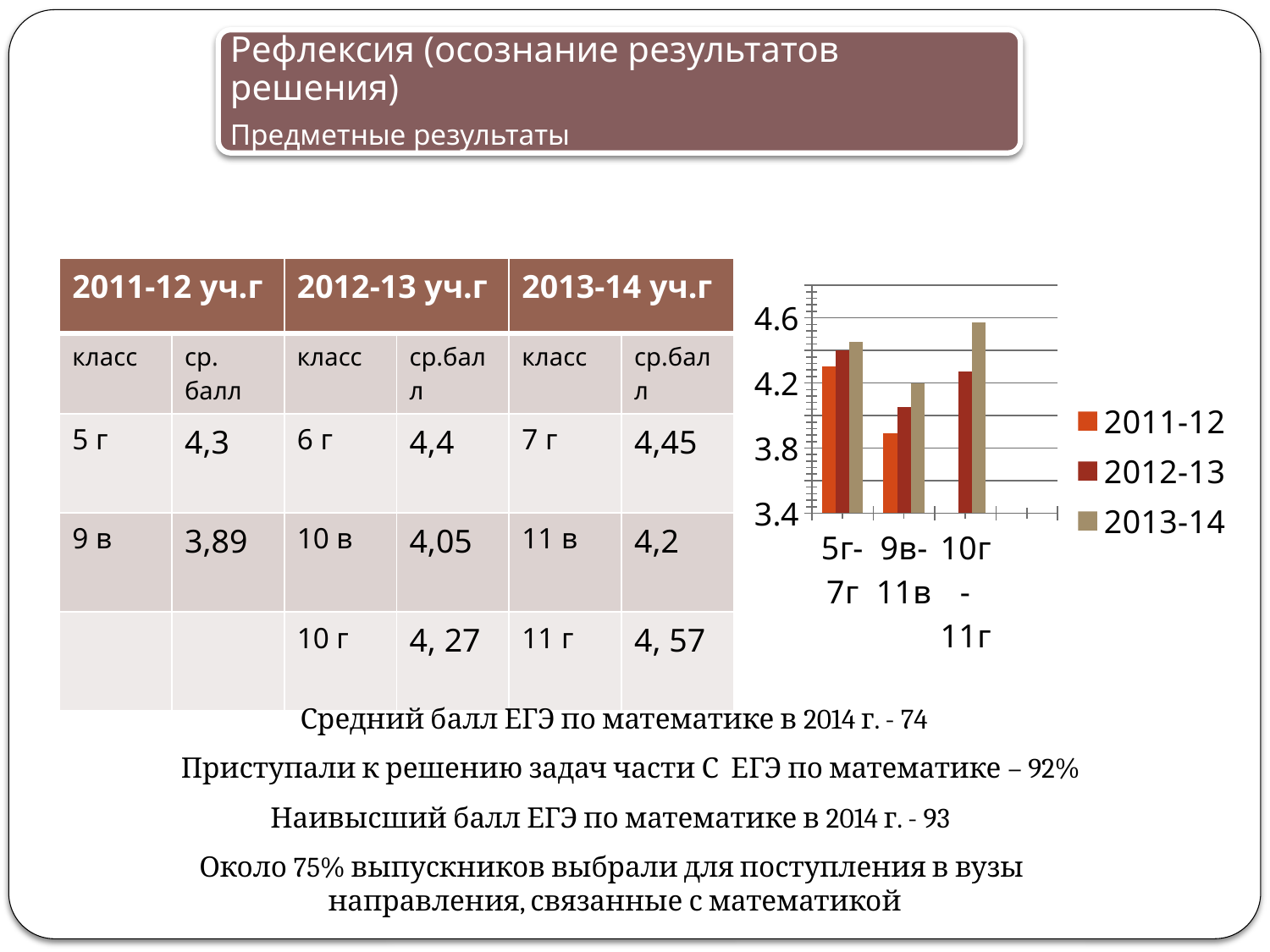
Within the 9в-11в category, do the values rise or fall from 2011-12 to 2013-14? rise Which category in the chart has no bar for the 2011-12 series? 10г-11г How many series does the chart legend list? 3 Is the 2012-13 value for 9в-11в greater or less than 3.8? greater Which is larger: the 2011-12 value for 5г-7г or the 2011-12 value for 9в-11в? 5г-7г In the 9в-11в category, which series has the highest bar? 2013-14 What kind of chart is shown on the slide? bar chart Is the 2011-12 value for 9в-11в greater or less than 4.2? less How many categories are shown on the x axis of the chart? 3 Which series and category has the shortest bar in the chart? 2011-12 for 9в-11в Is the 2013-14 value for 10г-11г greater or less than 4.2? greater Which series and category has the tallest bar in the chart? 2013-14 for 10г-11г